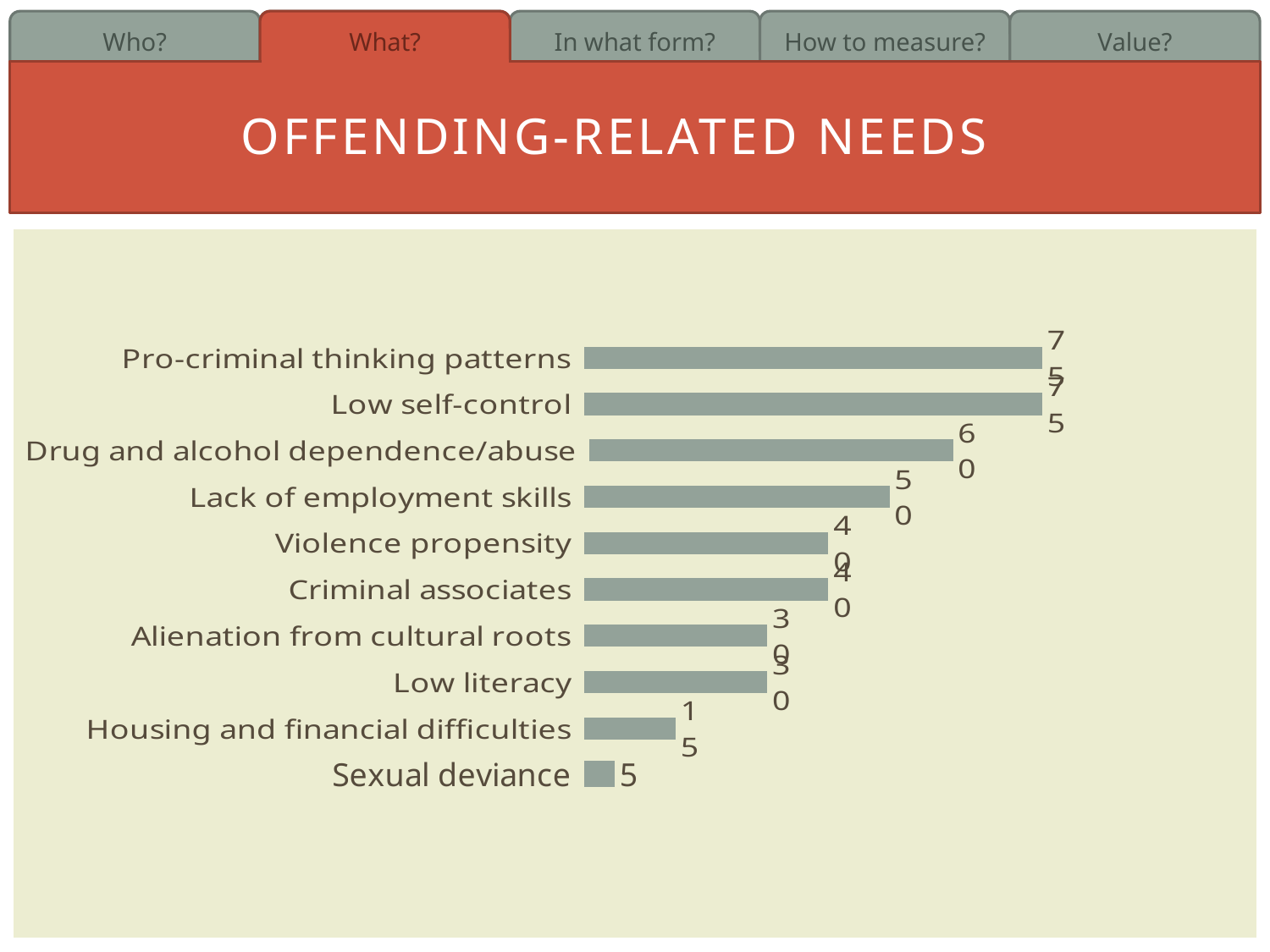
What type of chart is shown on the slide? bar chart Which is larger, the value for Violence propensity or the value for Low literacy? Violence propensity Which category has the lowest value in the chart? Sexual deviance What is the value for Sexual deviance? 5 What is the value for Drug and alcohol dependence/abuse? 60 What is the title shown in the red banner above the chart? OFFENDING-RELATED NEEDS Do the bar values increase or decrease going from the top category to the bottom category? decrease What is the value for Housing and financial difficulties? 15 Which is larger, the value for Drug and alcohol dependence/abuse or the value for Lack of employment skills? Drug and alcohol dependence/abuse How many categories are plotted in the chart? 10 What is the difference between the values for Drug and alcohol dependence/abuse and Lack of employment skills? 10 What is the value for Lack of employment skills? 50